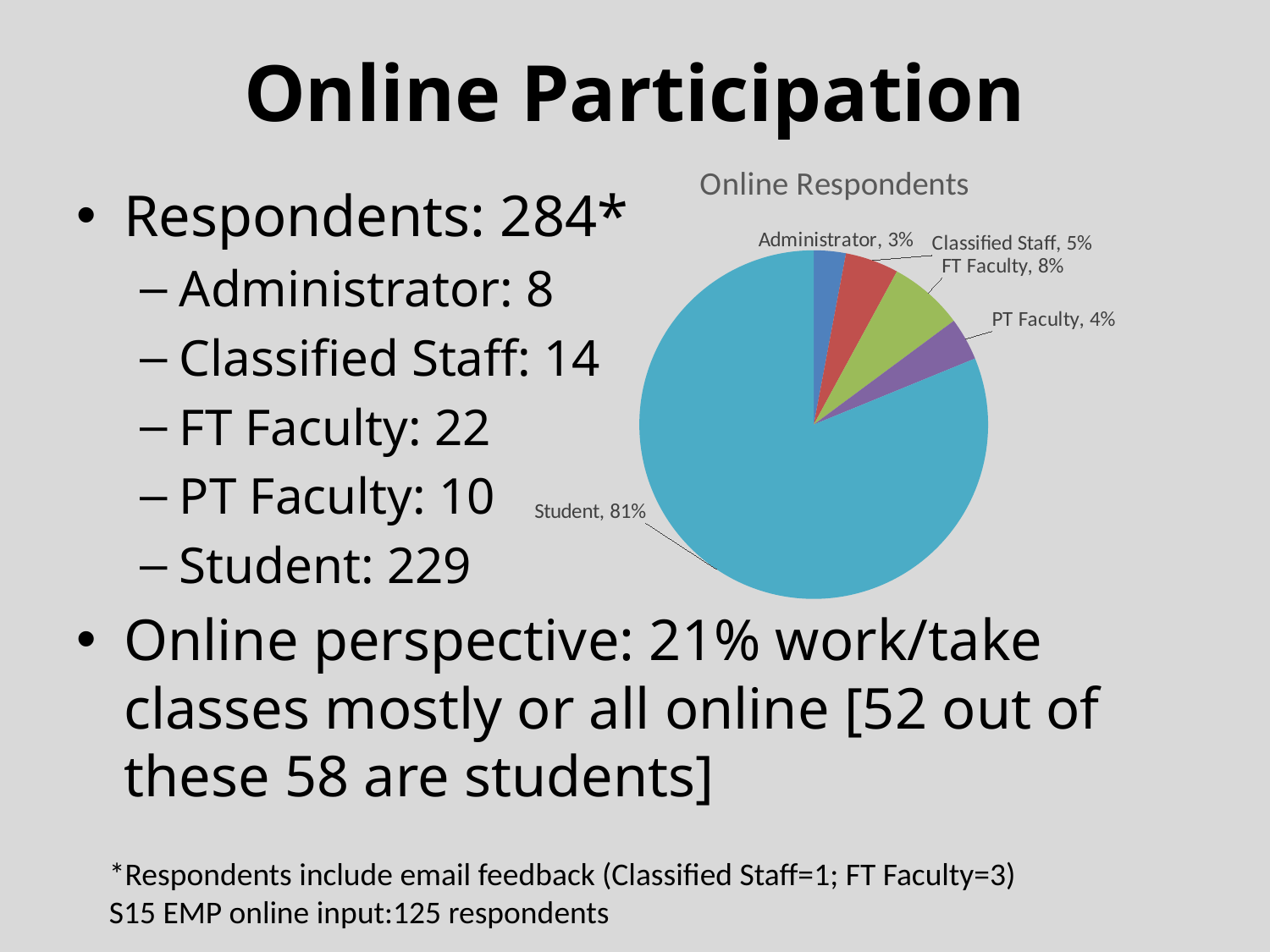
What is the difference between the Student share and the FT Faculty share? 73% How many categories are shown in the pie chart? 5 What share of the pie does Administrator represent? 3% What share of the pie does Classified Staff represent? 5% Which category has the largest slice of the pie? Student What share of the pie does FT Faculty represent? 8% What is the title of the chart? Online Respondents Which category has the smallest slice of the pie? Administrator Which is larger, the share for FT Faculty or the share for PT Faculty? FT Faculty What kind of chart is shown on the slide? pie chart